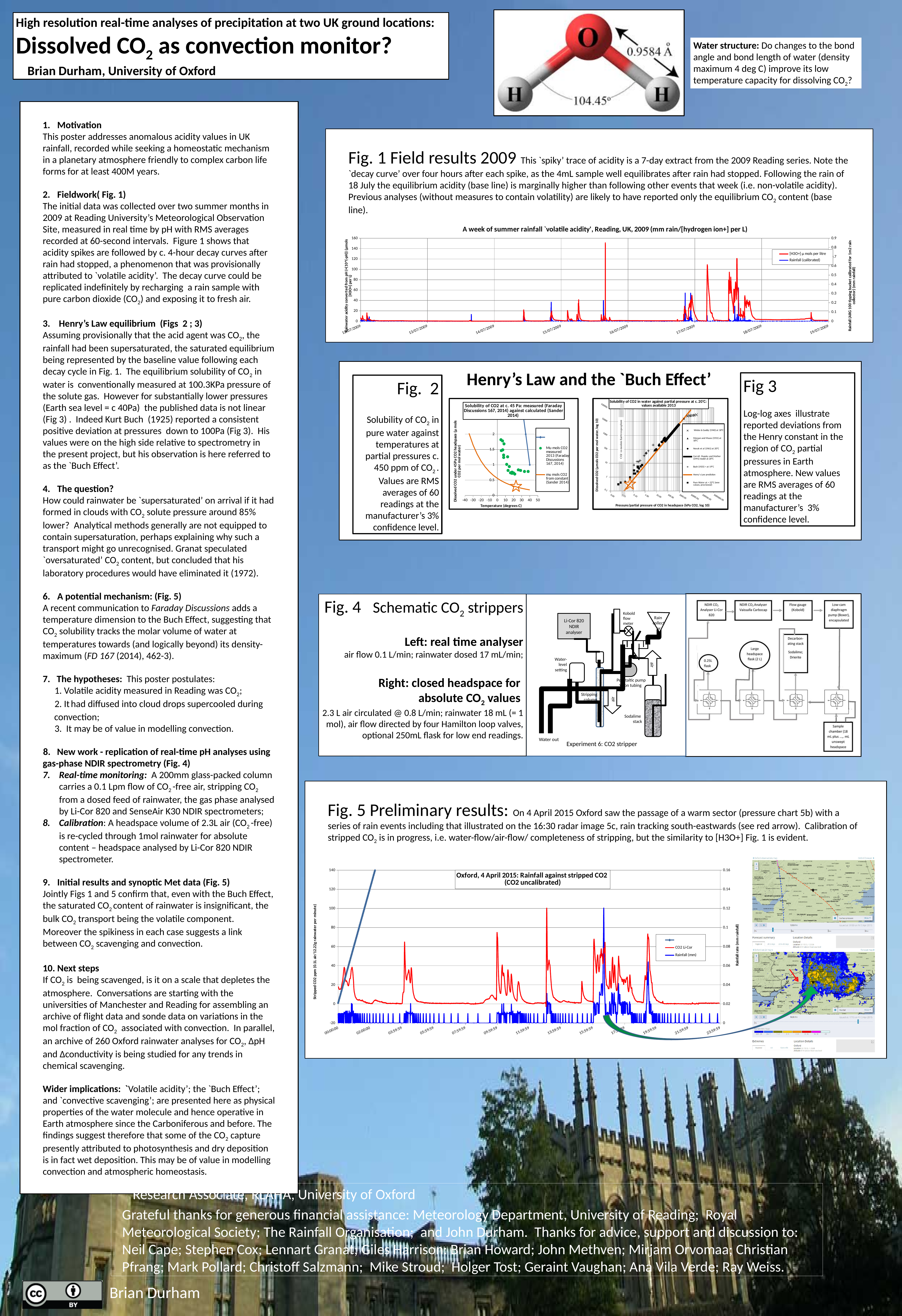
What kind of chart is the Fig. 2 chart of CO2 solubility against temperature? scatter chart How many series does the legend of the Fig. 1 chart (Reading, UK, 2009) list? 2 What kind of chart is the Fig. 1 chart titled 'A week of summer rainfall `volatile acidity', Reading, UK, 2009'? line chart In the Fig. 1 chart (Reading, UK, 2009), which series is drawn in blue? Rainfall (calibrated) What kind of chart is the Fig. 5 chart titled 'Oxford, 4 April 2015: Rainfall against stripped CO2'? line chart In the Fig. 5 chart (Oxford, 4 April 2015), is the peak CO2 Li-Cor value near 13:59:59 greater or less than 80 on the left axis? greater In the Fig. 1 chart (Reading, UK, 2009), which series is drawn in red? [H3O+] µ mols per litre How many series does the legend of the Fig. 2 chart (Solubility of CO2 at c. 45 Pa) list? 2 What is the maximum value shown on the left-hand axis of the Fig. 1 chart (Reading, UK, 2009)? 160